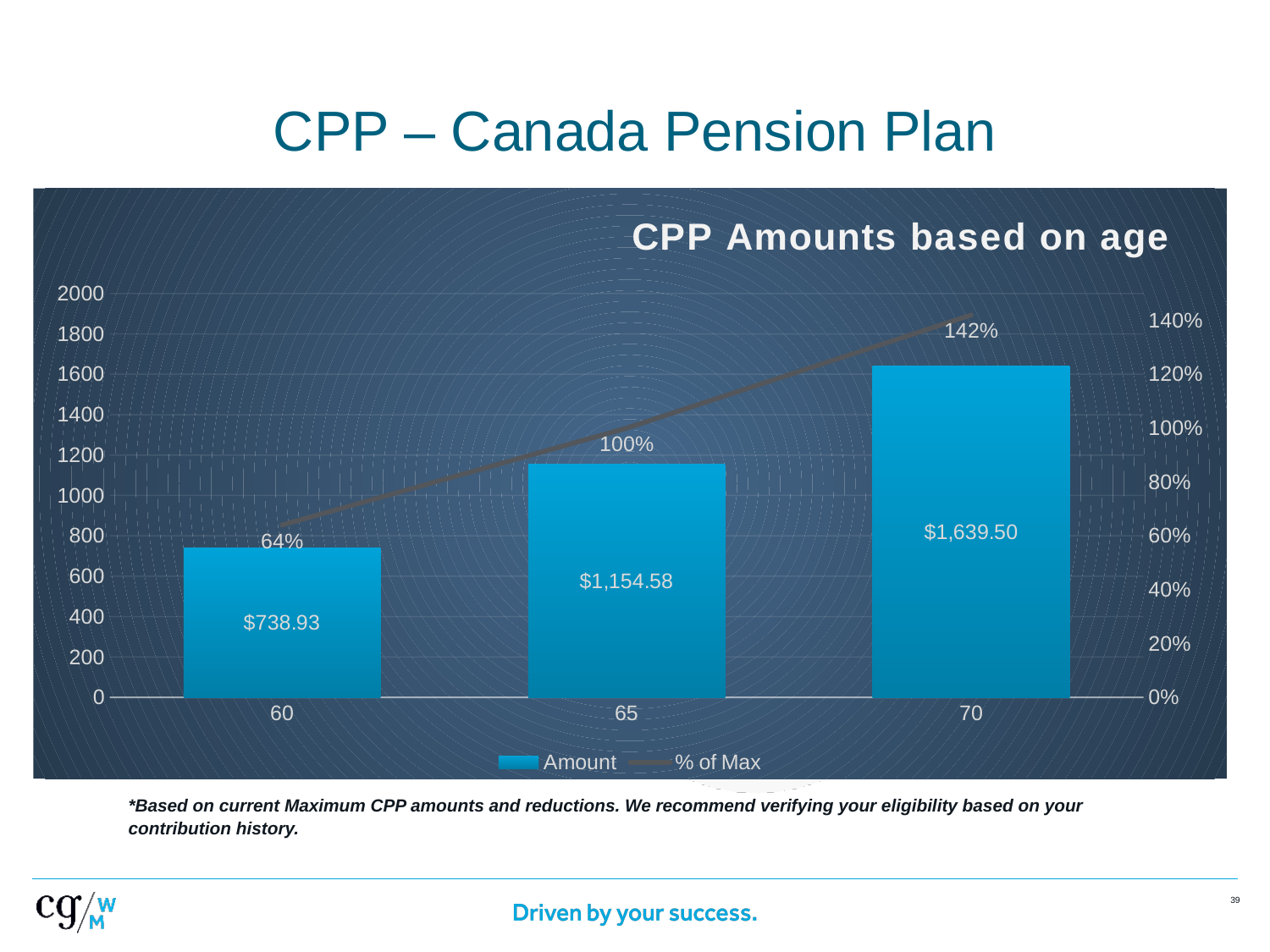
Which age has the lowest % of Max? 60 What is the difference in Amount between age 70 and age 65? $484.92 What is the % of Max value for age 60? 64% What is the Amount for age 60? $738.93 How many age categories are shown on the x axis? 3 Which age has the highest Amount? 70 Which is larger, the Amount for age 60 or the Amount for age 65? 65 What is the Amount for age 65? $1,154.58 Does the % of Max line rise or fall as age increases from 60 to 70? rise What is the % of Max value for age 70? 142% How many series does the legend list? 2 What is the title of the chart? CPP Amounts based on age